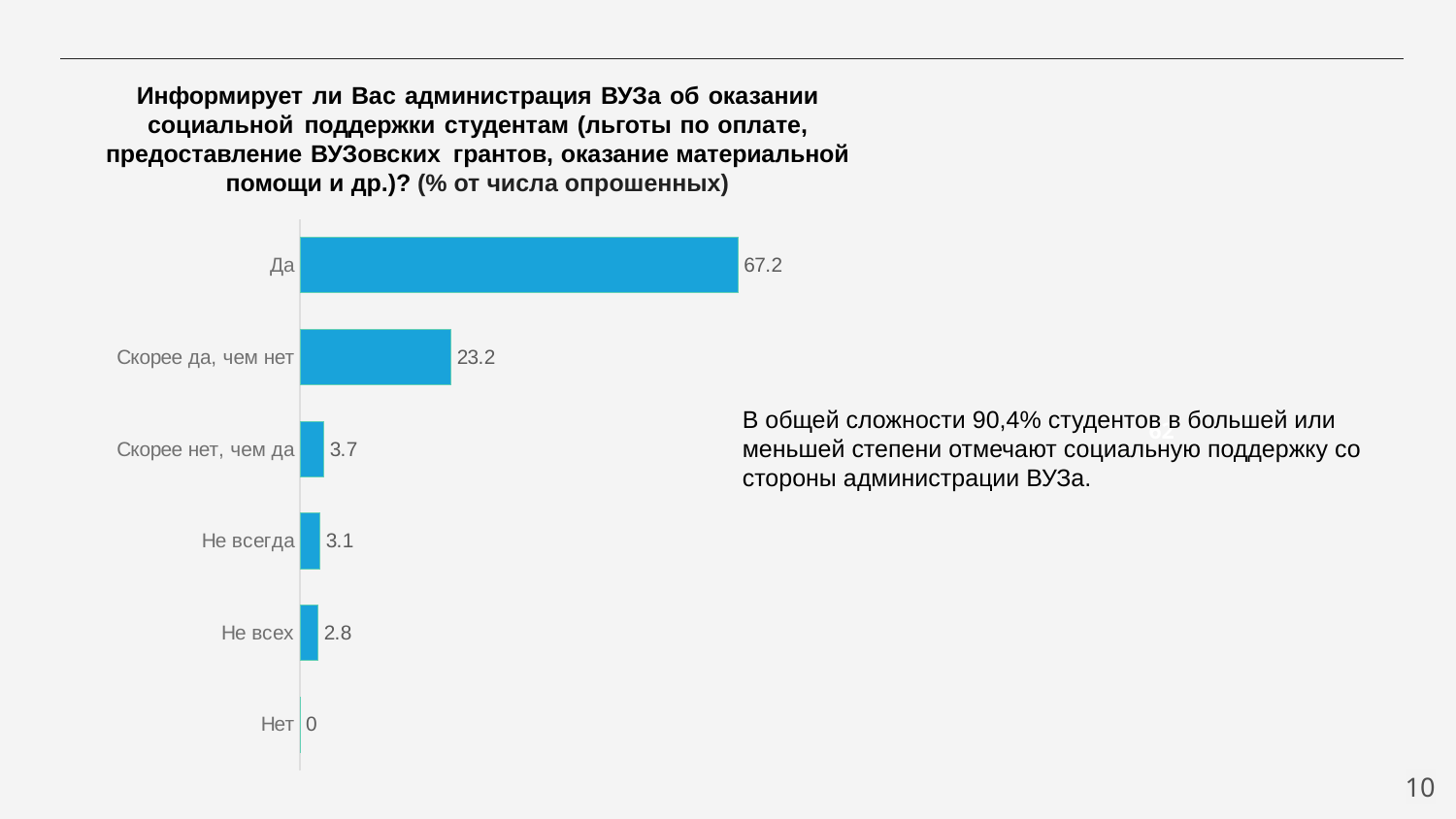
What is the value for "Нет"? 0 What is the difference between the values for "Да" and "Скорее да, чем нет"? 44 Which category has the lowest value? Нет Which category has the highest value? Да What is the value for "Да"? 67.2 What is the value for "Не всегда"? 3.1 What is the value for "Скорее да, чем нет"? 23.2 What colour are the bars in the chart? Blue What is the difference between the values for "Скорее нет, чем да" and "Не всех"? 0.9 What kind of chart is shown on the slide? Bar chart How many categories are shown in the chart? 6 Which is larger, the value for "Скорее нет, чем да" or the value for "Не всегда"? Скорее нет, чем да